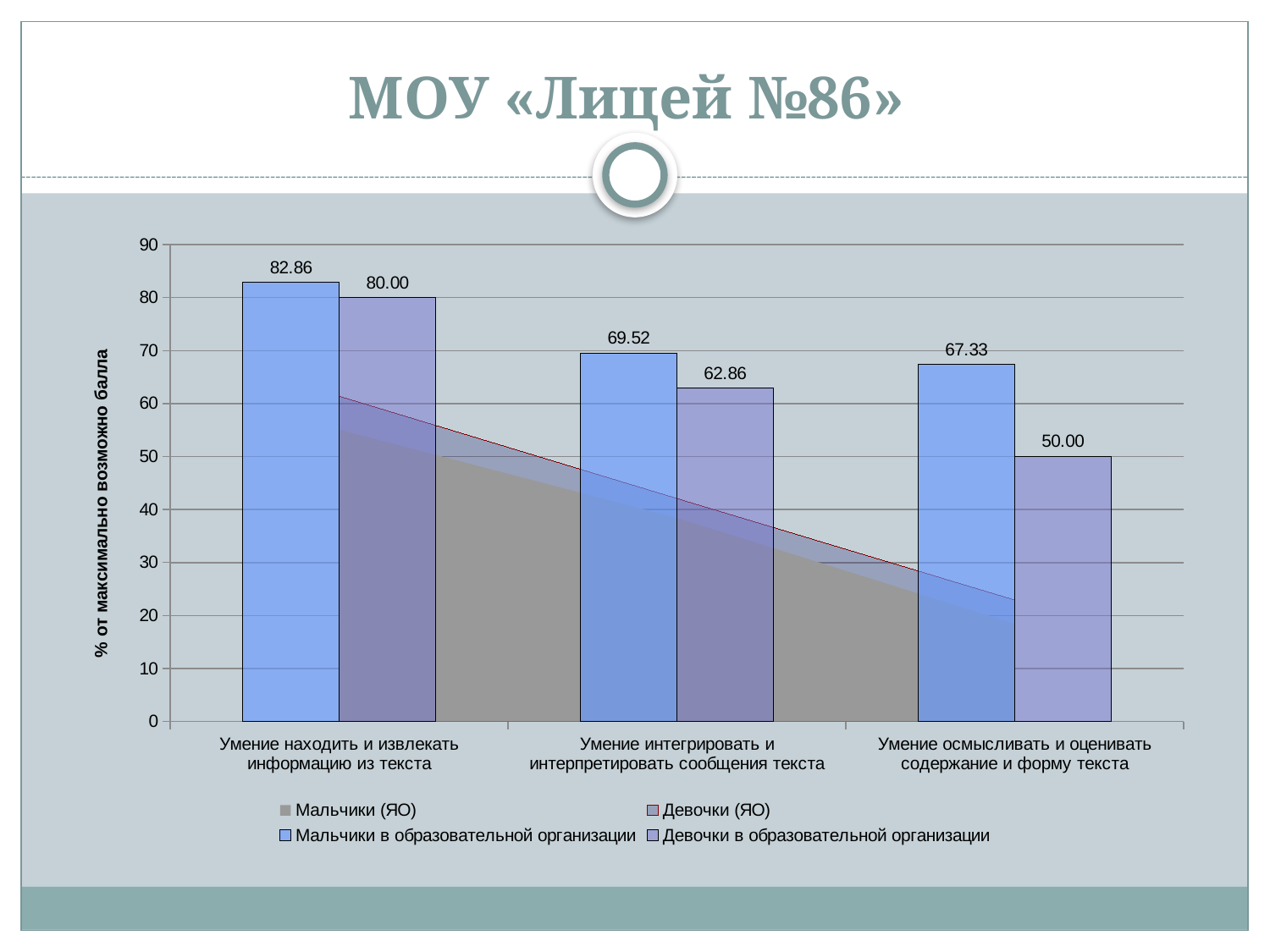
In which category is the value for Девочки в образовательной организации the lowest? Умение осмысливать и оценивать содержание и форму текста In which category is the value for Мальчики в образовательной организации the highest? Умение находить и извлекать информацию из текста Which is larger in the category Умение находить и извлекать информацию из текста: Мальчики в образовательной организации or Девочки в образовательной организации? Мальчики в образовательной организации What is the difference between Мальчики в образовательной организации and Девочки в образовательной организации in the category Умение осмысливать и оценивать содержание и форму текста? 17.33 What is the value for Мальчики в образовательной организации in the category Умение находить и извлекать информацию из текста? 82.86 What is the value for Девочки в образовательной организации in the category Умение осмысливать и оценивать содержание и форму текста? 50.00 What is the value for Девочки в образовательной организации in the category Умение интегрировать и интерпретировать сообщения текста? 62.86 How many categories are shown on the x axis? 3 Is the value for Девочки (ЯО) in the category Умение находить и извлекать информацию из текста greater or less than 50? greater Do the values for Мальчики в образовательной организации rise or fall from left to right across the categories? fall How many series does the legend list? 4 What is the difference between Мальчики в образовательной организации and Девочки в образовательной организации in the category Умение интегрировать и интерпретировать сообщения текста? 6.66